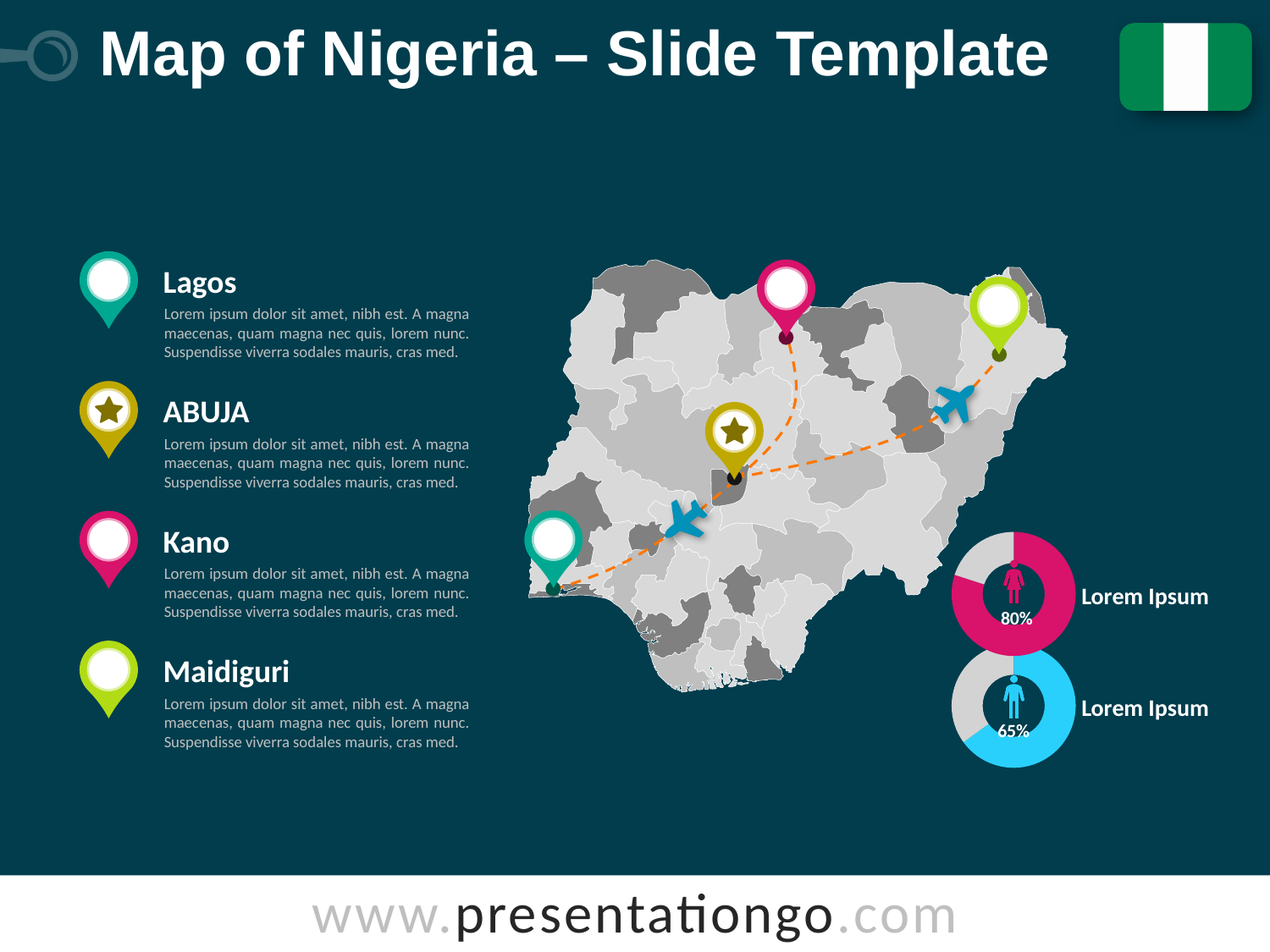
What text label is placed to the right of each donut chart? Lorem Ipsum What share of the upper donut chart is left unfilled (grey)? 20% Which donut chart shows the smaller value? the blue one (65%) What kind of chart is used to display the 80% and 65% values? donut chart What value is printed in the centre of the lower (blue) donut chart? 65% How many donut charts are shown on the slide? 2 Which of the two donut charts shows the larger value, the pink one or the blue one? the pink one (80%) What icon appears inside the pink 80% donut chart? a female figure What is the difference between the values shown in the pink and blue donut charts? 15 percentage points What share of the lower donut chart is left unfilled (grey)? 35% What value is printed in the centre of the upper (pink) donut chart? 80%